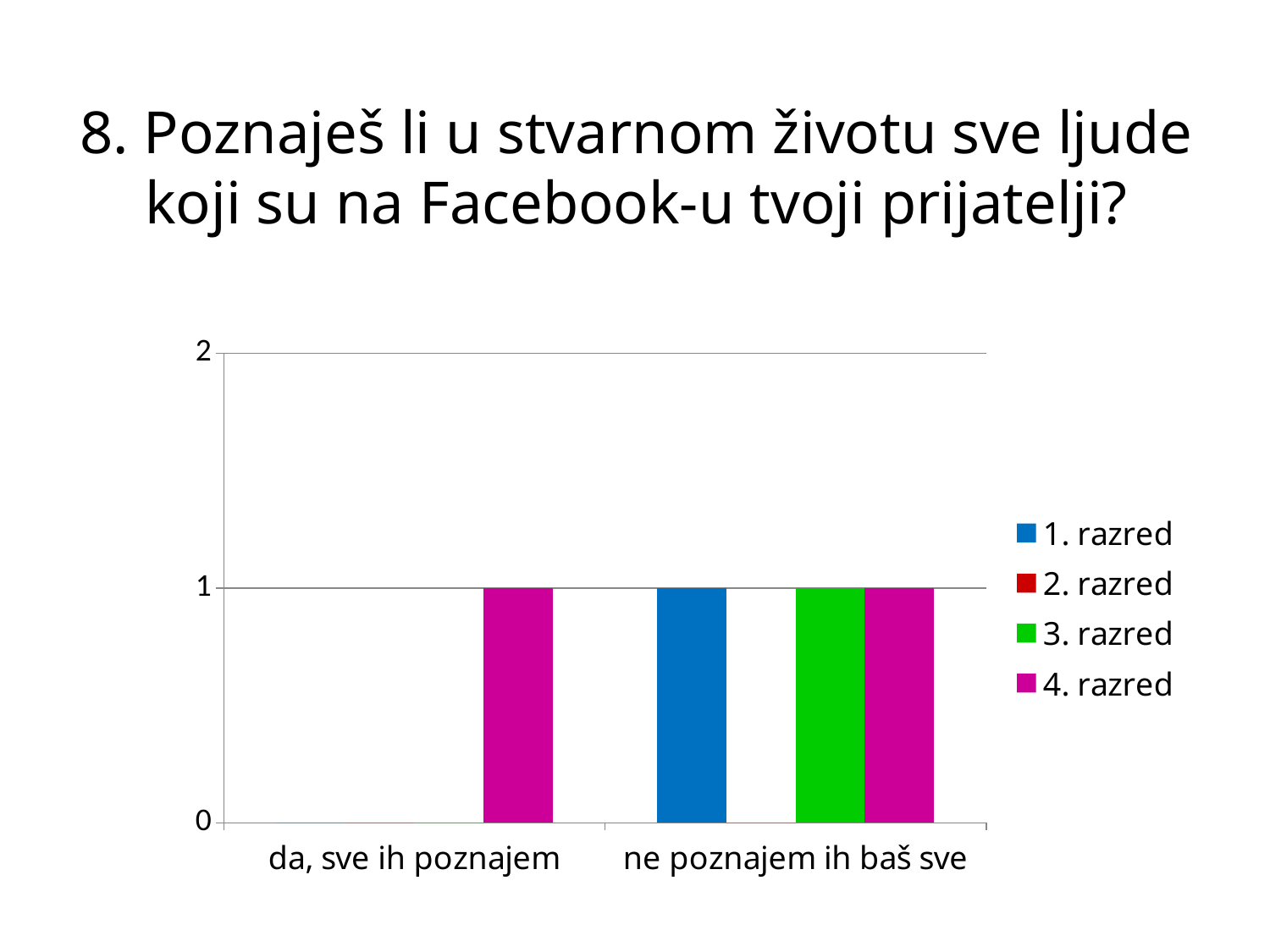
What is the value for 3. razred in the category "ne poznajem ih baš sve"? 1 What is the value for 4. razred in the category "da, sve ih poznajem"? 1 Is the value for 4. razred in "ne poznajem ih baš sve" greater or less than 2? less What is the value for 1. razred in the category "ne poznajem ih baš sve"? 1 What is the difference between the value for 1. razred in "ne poznajem ih baš sve" and the value for 4. razred in "da, sve ih poznajem"? 0 How many series does the legend list? 4 For 1. razred, which category has the larger value: "da, sve ih poznajem" or "ne poznajem ih baš sve"? ne poznajem ih baš sve Which category has more visible bars? ne poznajem ih baš sve What kind of chart is shown on the slide? bar chart What are the entries listed in the legend? 1. razred, 2. razred, 3. razred, 4. razred How many categories are shown on the x axis? 2 What is the value for 4. razred in the category "ne poznajem ih baš sve"? 1